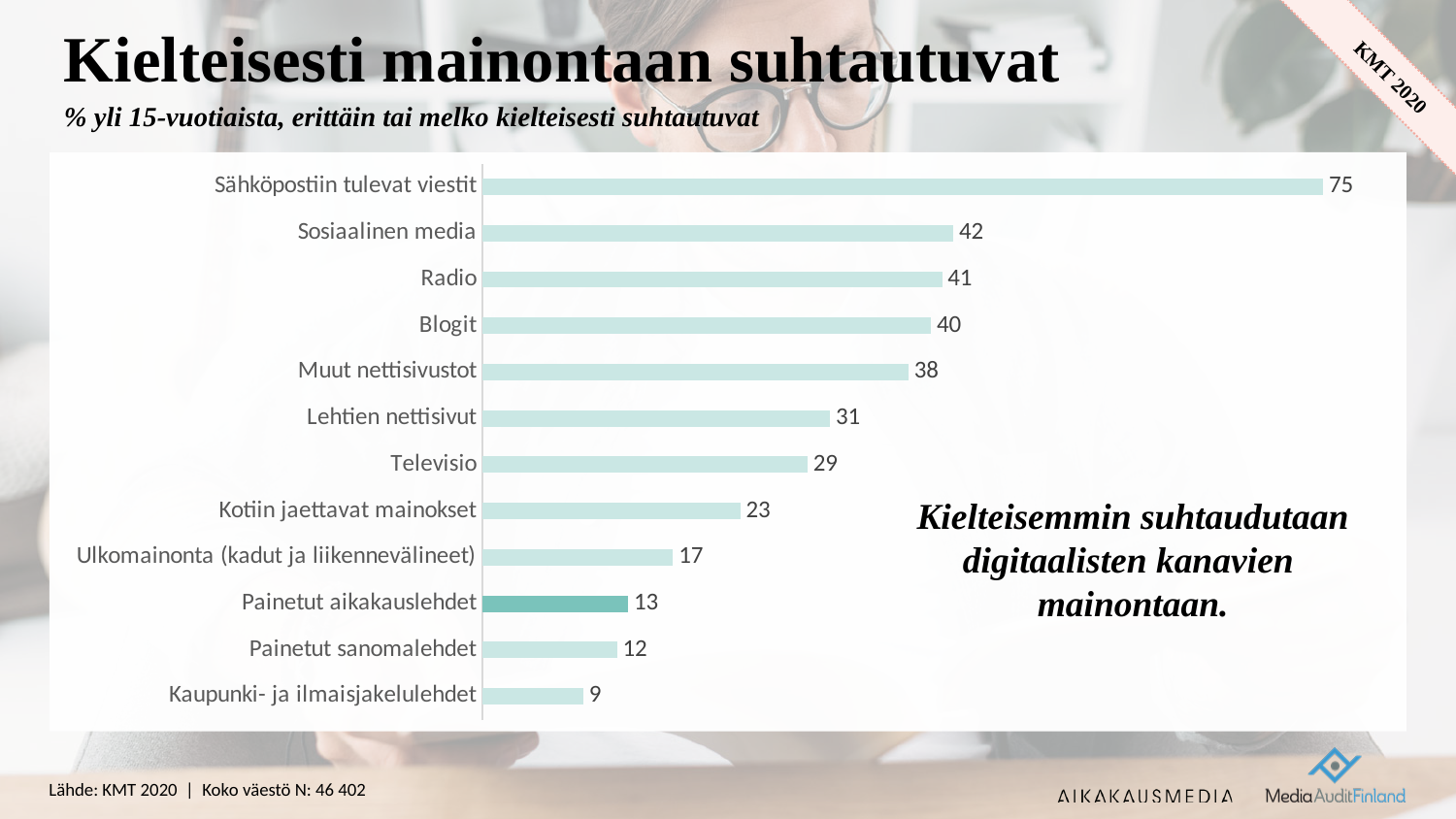
What is the difference between the values for Sosiaalinen media and Radio? 1 How many categories are shown in the chart? 12 What kind of chart is shown on the slide? Bar chart Which category has the highest value? Sähköpostiin tulevat viestit What is the value for Sähköpostiin tulevat viestit? 75 What is the title of the slide containing the chart? Kielteisesti mainontaan suhtautuvat What is the value for Ulkomainonta (kadut ja liikennevälineet)? 17 What is the value for Televisio? 29 What is the value for Painetut aikakauslehdet? 13 Which category has the lowest value? Kaupunki- ja ilmaisjakelulehdet Which is larger, the value for Lehtien nettisivut or the value for Kotiin jaettavat mainokset? Lehtien nettisivut What is the difference between the values for Sähköpostiin tulevat viestit and Kaupunki- ja ilmaisjakelulehdet? 66